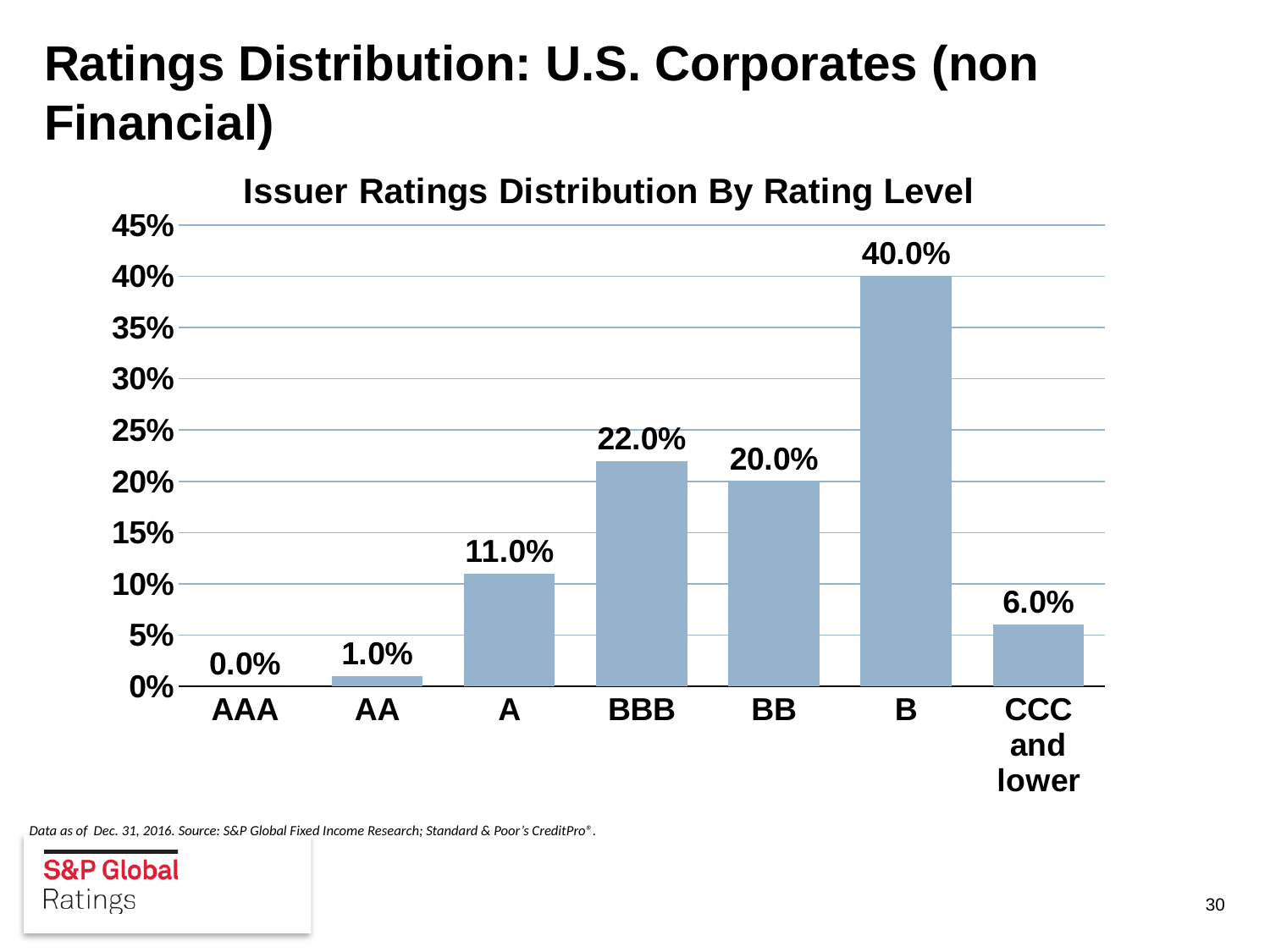
What is the value for the BBB rating level? 22.0% What is the value for CCC and lower? 6.0% What is the value for the B rating level? 40.0% Which is larger, the value for BBB or the value for BB? BBB What is the difference between the values for BBB and A? 11.0% Which rating level has the lowest share of issuers? AAA Which rating level has the highest share of issuers? B How many rating levels are shown on the x axis? 7 What is the difference between the values for B and BB? 20.0% Is the value for A greater or less than 10%? greater What is the title of the chart? Issuer Ratings Distribution By Rating Level What kind of chart is shown on the slide? bar chart